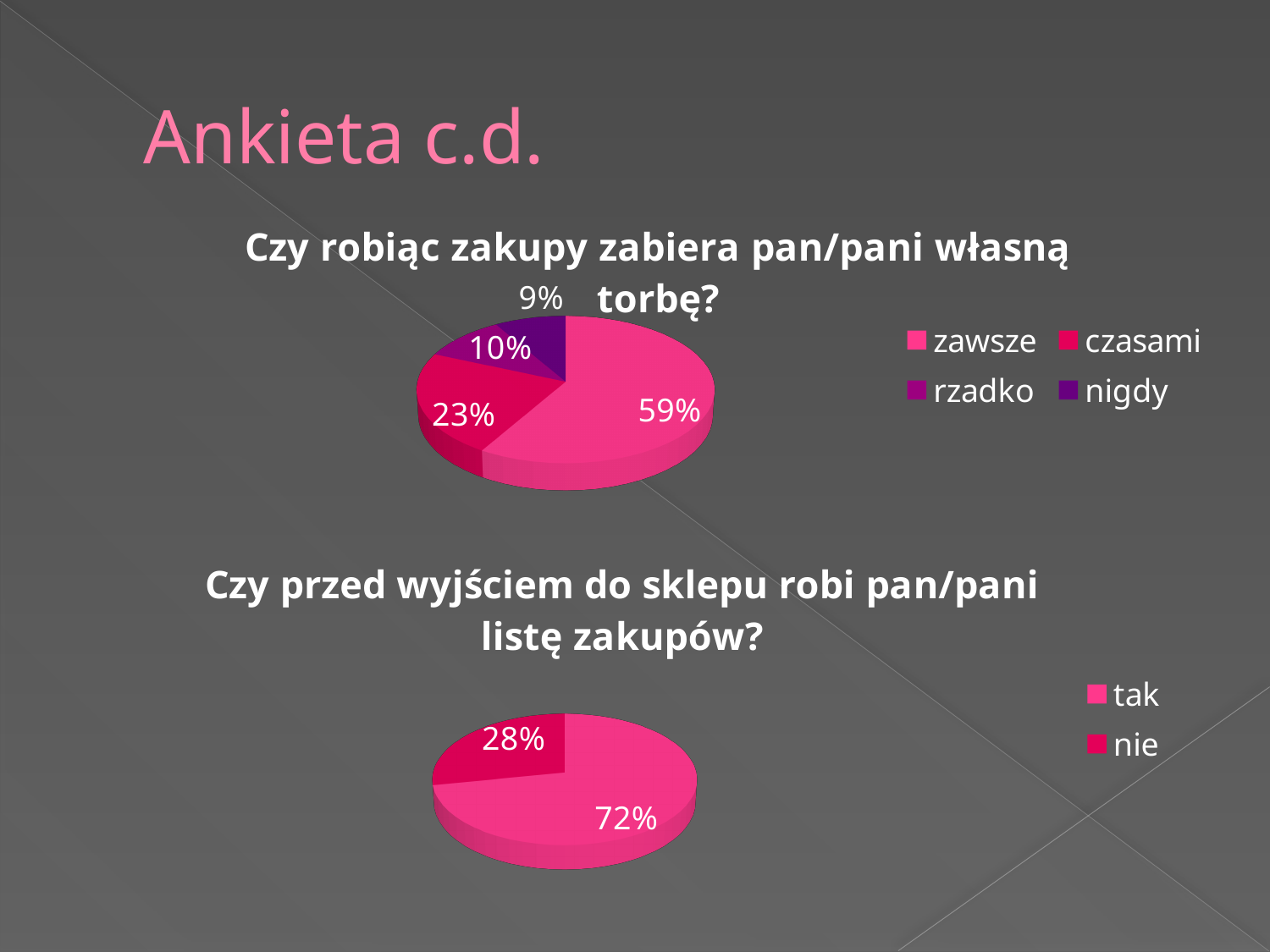
What kind of chart is the bottom chart ("Czy przed wyjściem do sklepu robi pan/pani listę zakupów?")? Pie chart In the bottom chart ("Czy przed wyjściem do sklepu robi pan/pani listę zakupów?"), what is the value for "nie"? 28% In the top chart ("Czy robiąc zakupy zabiera pan/pani własną torbę?"), what is the value for "rzadko"? 10% In the top chart ("Czy robiąc zakupy zabiera pan/pani własną torbę?"), which category has the largest slice? zawsze In the bottom chart ("Czy przed wyjściem do sklepu robi pan/pani listę zakupów?"), which is larger, "tak" or "nie"? tak In the top chart ("Czy robiąc zakupy zabiera pan/pani własną torbę?"), what is the difference between the "zawsze" and "czasami" shares? 36% In the bottom chart ("Czy przed wyjściem do sklepu robi pan/pani listę zakupów?"), what share of the pie is "tak"? 72% In the bottom chart ("Czy przed wyjściem do sklepu robi pan/pani listę zakupów?"), what is the difference between the "tak" and "nie" shares? 44% In the top chart ("Czy robiąc zakupy zabiera pan/pani własną torbę?"), what share of the pie is "czasami"? 23% In the top chart ("Czy robiąc zakupy zabiera pan/pani własną torbę?"), what share of the pie is "zawsze"? 59% How many categories does the legend of the top chart ("Czy robiąc zakupy zabiera pan/pani własną torbę?") list? 4 In the top chart ("Czy robiąc zakupy zabiera pan/pani własną torbę?"), which category has the smallest slice? nigdy